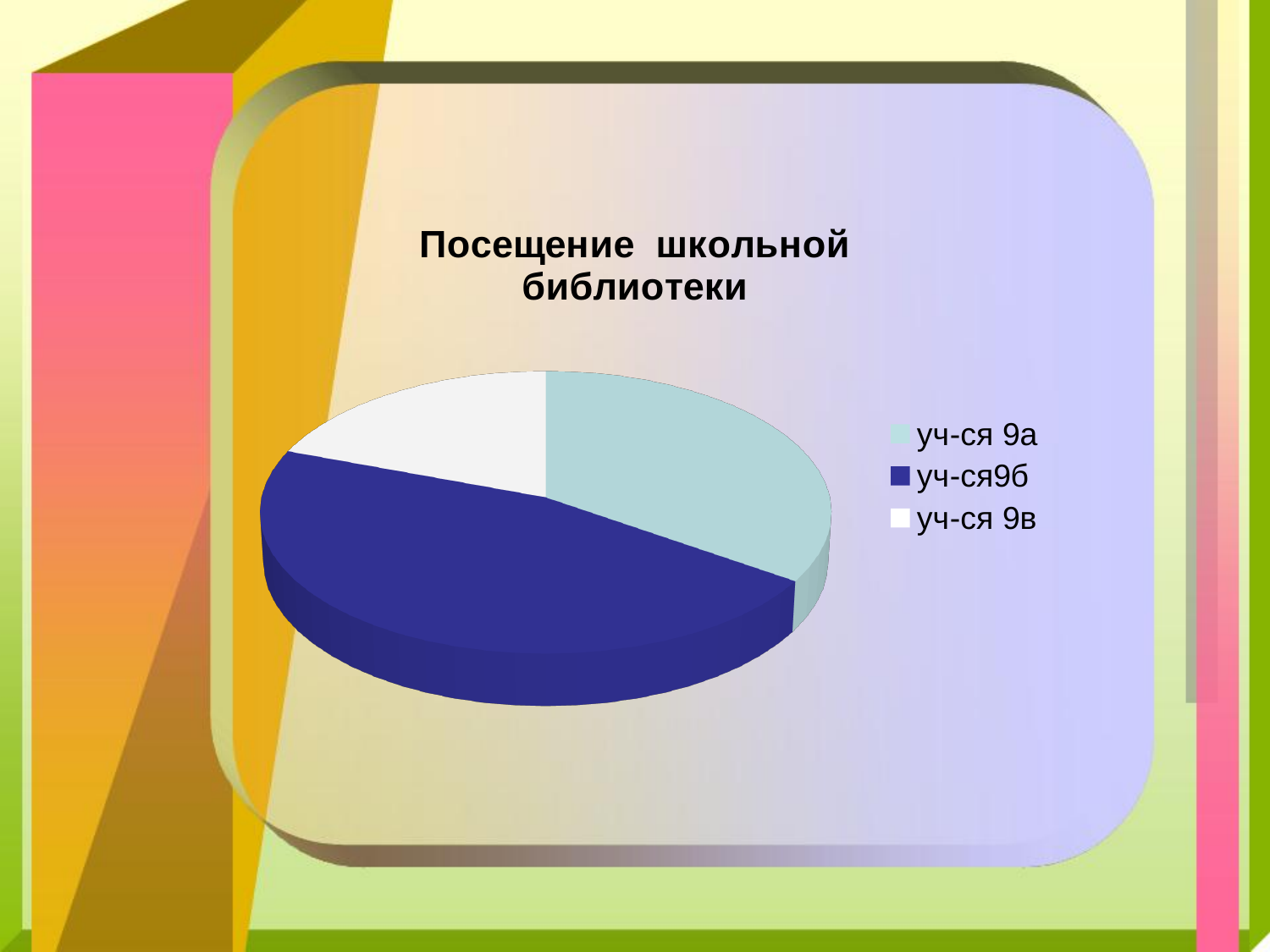
What colour is the slice for уч-ся9б? dark blue Which category has the smallest slice of the pie? уч-ся 9в What is the title of the chart? Посещение школьной библиотеки How many slices does the pie chart have? 3 Which slice is larger, уч-ся 9а or уч-ся 9в? уч-ся 9а Which slice is larger, уч-ся 9а or уч-ся9б? уч-ся9б What kind of chart is shown on the slide? pie chart How many entries does the legend list? 3 Which category has the largest slice of the pie? уч-ся9б